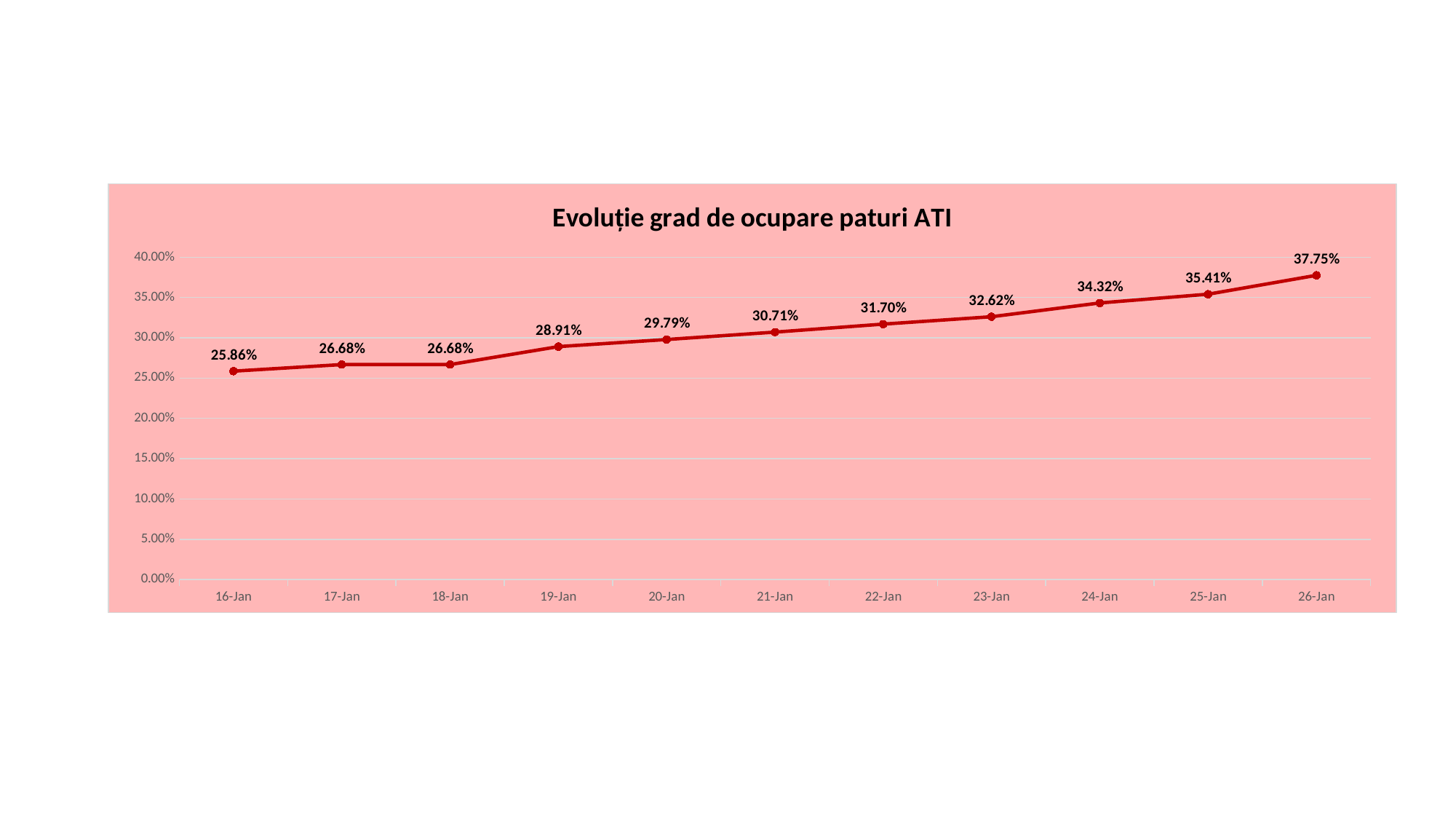
Is the value for 24-Jan greater or less than 30.00%? greater What is the value for 22-Jan? 31.70% What kind of chart is shown? line chart Which date has the lowest value? 16-Jan Do the values rise or fall from 16-Jan to 26-Jan? rise What is the value for 16-Jan? 25.86% Which is larger, the value for 19-Jan or the value for 23-Jan? 23-Jan How many dates are plotted on the x axis? 11 What is the value for 26-Jan? 37.75% What is the difference between the values for 25-Jan and 24-Jan? 1.09% Which date has the highest value? 26-Jan What is the difference between the values for 26-Jan and 16-Jan? 11.89%